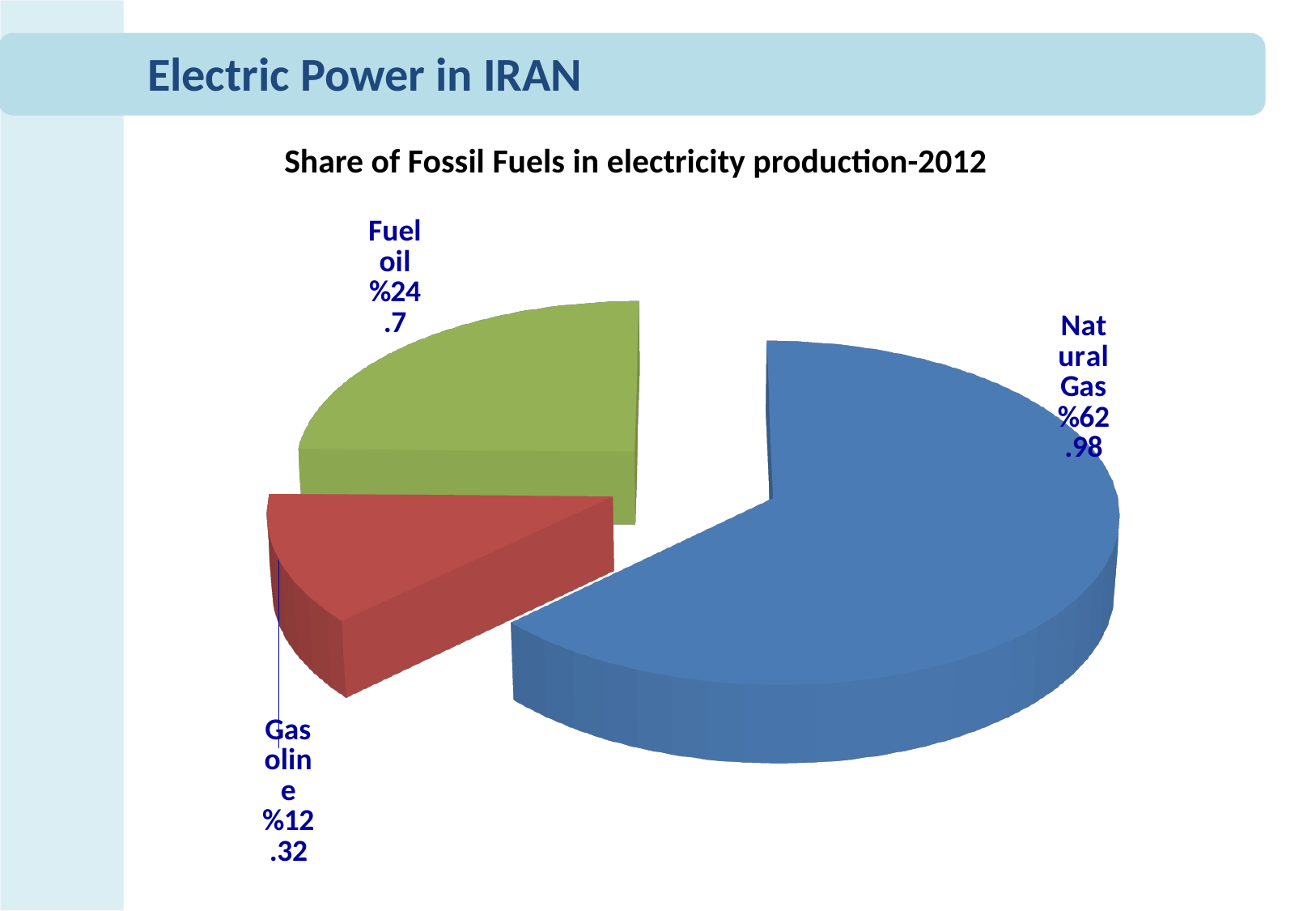
Which has a larger share, Fuel oil or Gasoline? Fuel oil What is the title of the chart? Share of Fossil Fuels in electricity production-2012 What colour is the Natural Gas slice? blue What share of electricity production does Fuel oil have? 24.7% What kind of chart is shown on the slide? pie chart What share of electricity production does Gasoline have? 12.32% How many slices does the pie chart have? 3 What is the difference in percentage points between the Natural Gas share and the Fuel oil share? 38.28 What is the difference in percentage points between the Fuel oil share and the Gasoline share? 12.38 Which fuel has the smallest share of the pie? Gasoline Which fuel has the largest share of the pie? Natural Gas What share of electricity production does Natural Gas have? 62.98%